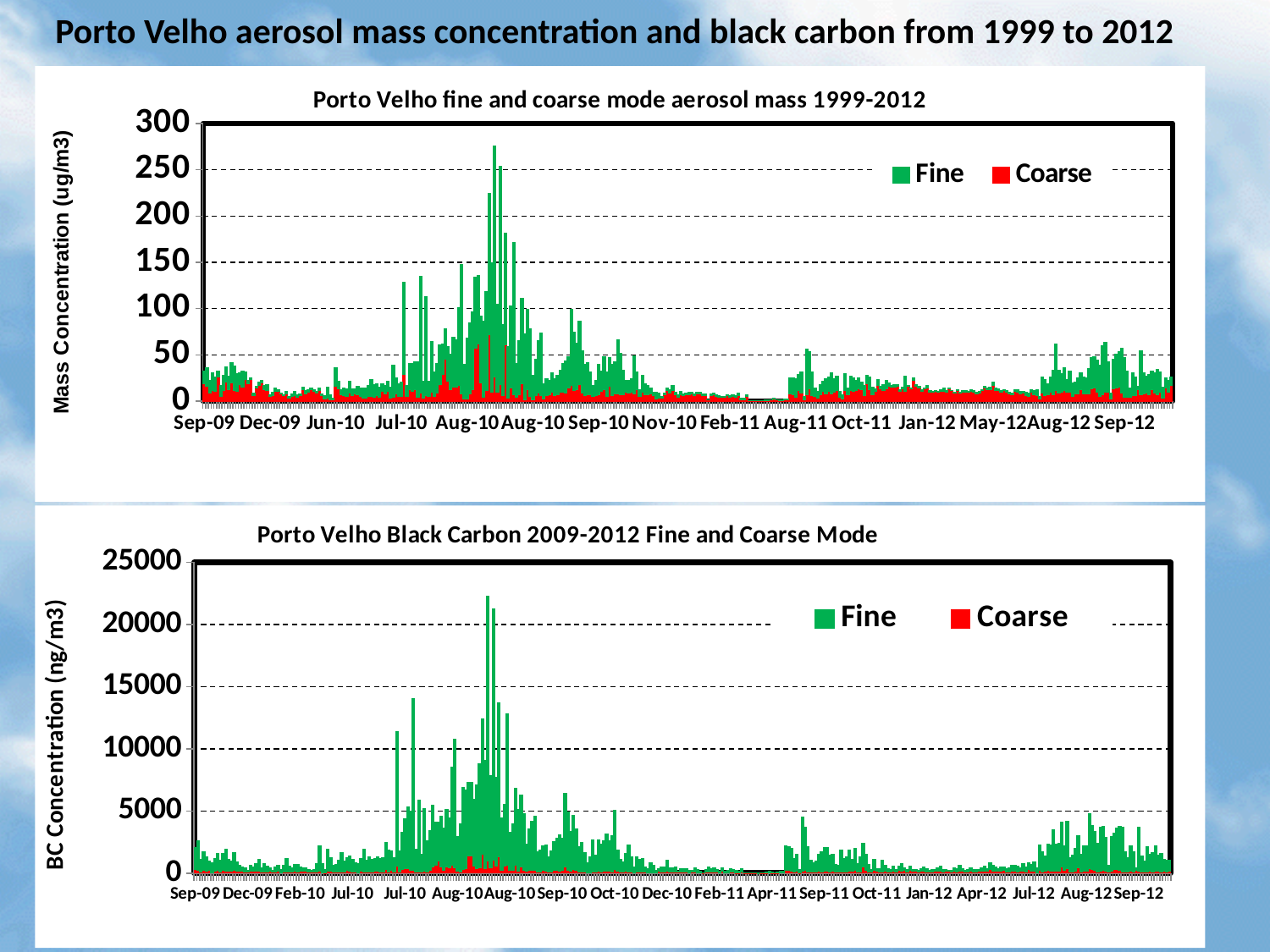
In the bottom chart, which series reaches higher values, Fine or Coarse? Fine In the bottom chart, is the Coarse value around Aug-10 greater or less than 5000? less How many series does the legend of the top chart list? 2 In the bottom chart, is the highest Fine peak (around Aug-10) greater or less than 20000? greater In the top chart, is the Fine value around Feb-11 greater or less than 50? less In the top chart, which series is shown in green? Fine What are the two series named in the legend of the bottom chart, 'Porto Velho Black Carbon 2009-2012 Fine and Coarse Mode'? Fine and Coarse In the top chart, which series reaches higher values, Fine or Coarse? Fine What kind of chart is the top chart, 'Porto Velho fine and coarse mode aerosol mass 1999-2012'? bar chart What is the maximum value shown on the y axis of the bottom chart? 25000 What kind of chart is the bottom chart? bar chart